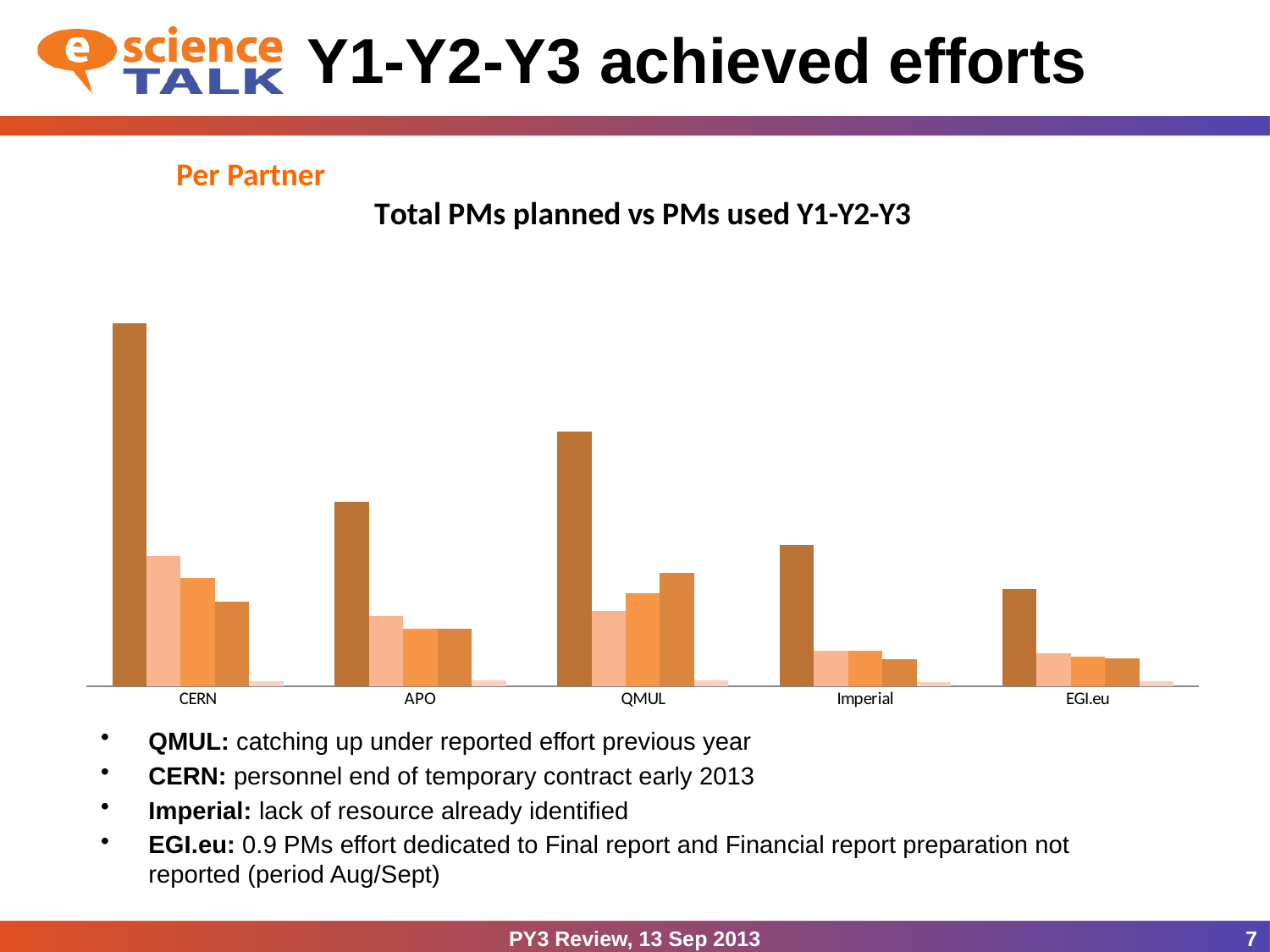
Which partner is listed first on the x axis of the chart? CERN Which partner has the tallest bar in the chart? CERN Which partner has the shortest first (dark brown) bar in the chart? EGI.eu Is the first (dark brown) bar for CERN or for QMUL taller? CERN What is the title of the chart? Total PMs planned vs PMs used Y1-Y2-Y3 What kind of chart is shown on the slide? bar chart Which partner is listed last on the x axis of the chart? EGI.eu Which partner has the second tallest first (dark brown) bar? QMUL Is the first (dark brown) bar for Imperial or for EGI.eu taller? Imperial Is the first (dark brown) bar for APO or for QMUL taller? QMUL How many partners (categories) are shown on the x axis of the chart? 5